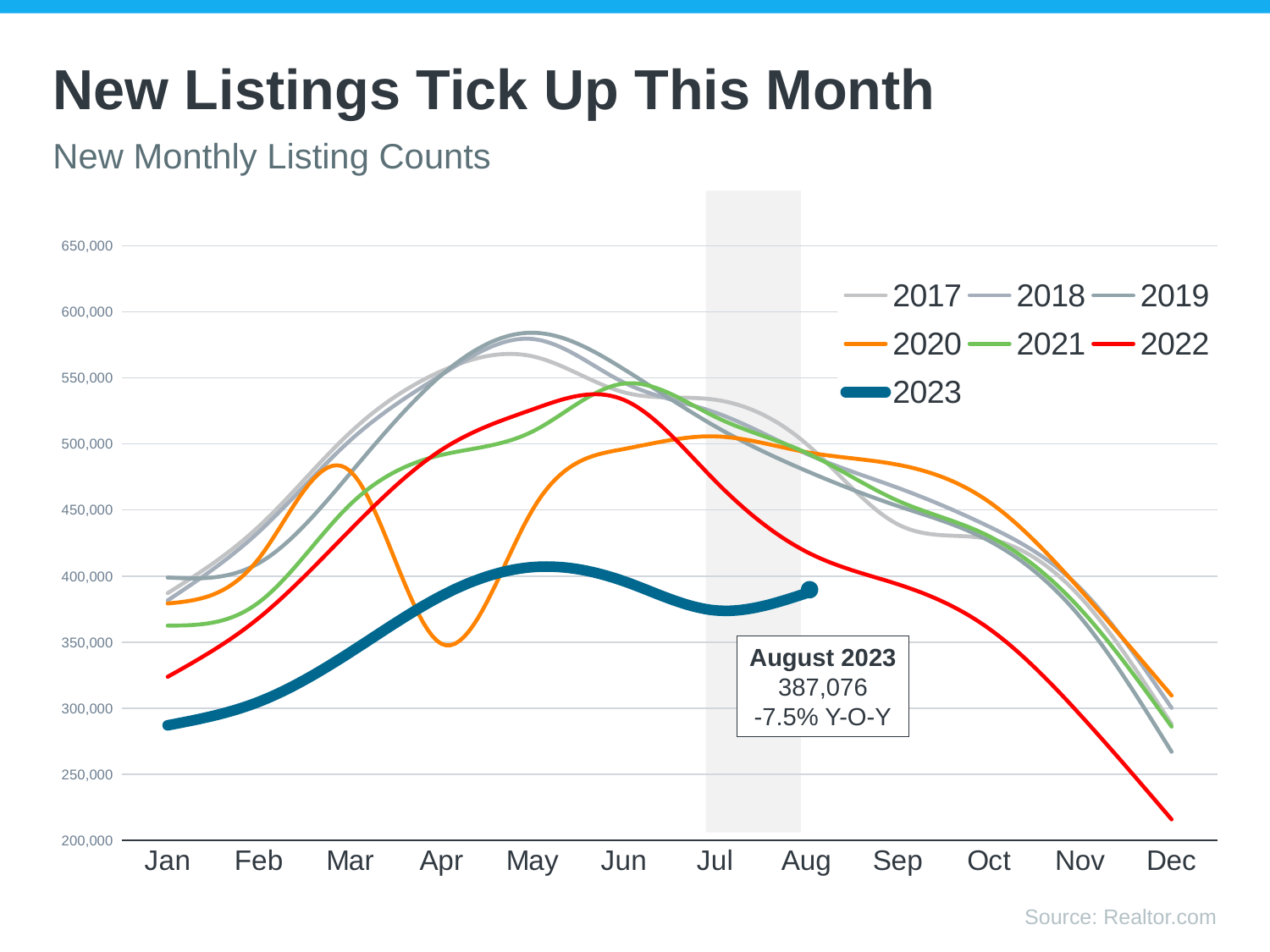
What is the new listing count for August 2023 shown in the callout? 387,076 Does the 2023 line rise or fall from January to May? rise Which is larger in August: the value for 2022 or the value for 2023? 2022 Is the value for 2020 in April greater or less than 400,000? less What kind of chart is shown on the slide? line chart Is the value for 2023 in January greater or less than 300,000? less What year-over-year change is shown for August 2023? -7.5% Y-O-Y What is the subtitle of the chart? New Monthly Listing Counts How many months are shown along the x axis? 12 Is the value for 2022 in December greater or less than 250,000? less How many series does the legend list? 7 Which year has the lowest value in December? 2022